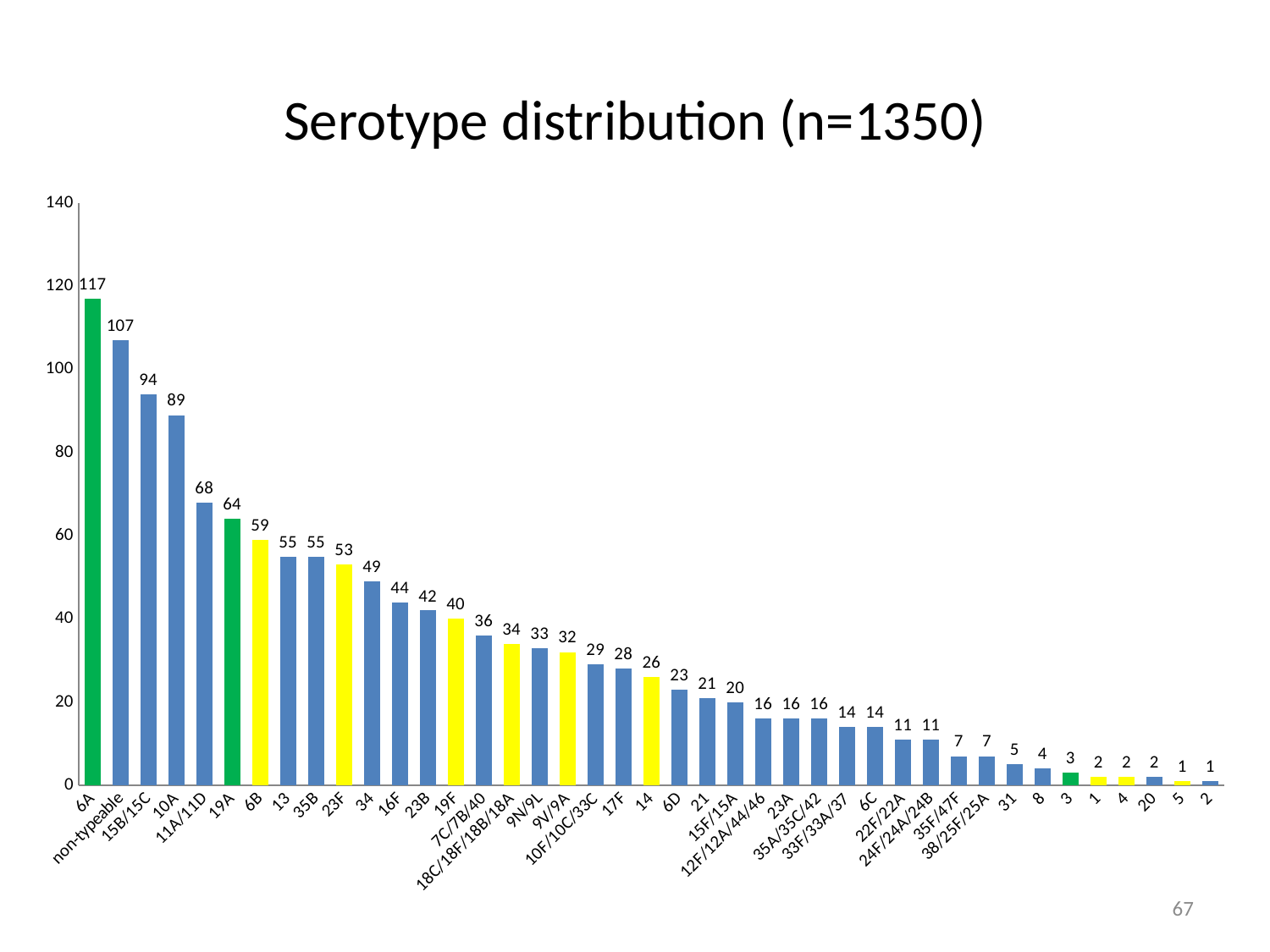
What is the value for serotype 19F? 40 What is the difference between the values for 6A and non-typeable? 10 Which is larger, the value for 15B/15C or the value for 10A? 15B/15C What is the difference between the values for 6B and 23F? 6 What is the title of the chart? Serotype distribution (n=1350) What is the value for serotype 6A? 117 Do the values rise or fall from left to right along the x axis? fall What kind of chart is shown on the slide? bar chart What is the value for 12F/12A/44/46? 16 What is the value for the non-typeable category? 107 Is the value for 11A/11D greater or less than 60? greater Which serotype has the highest value? 6A